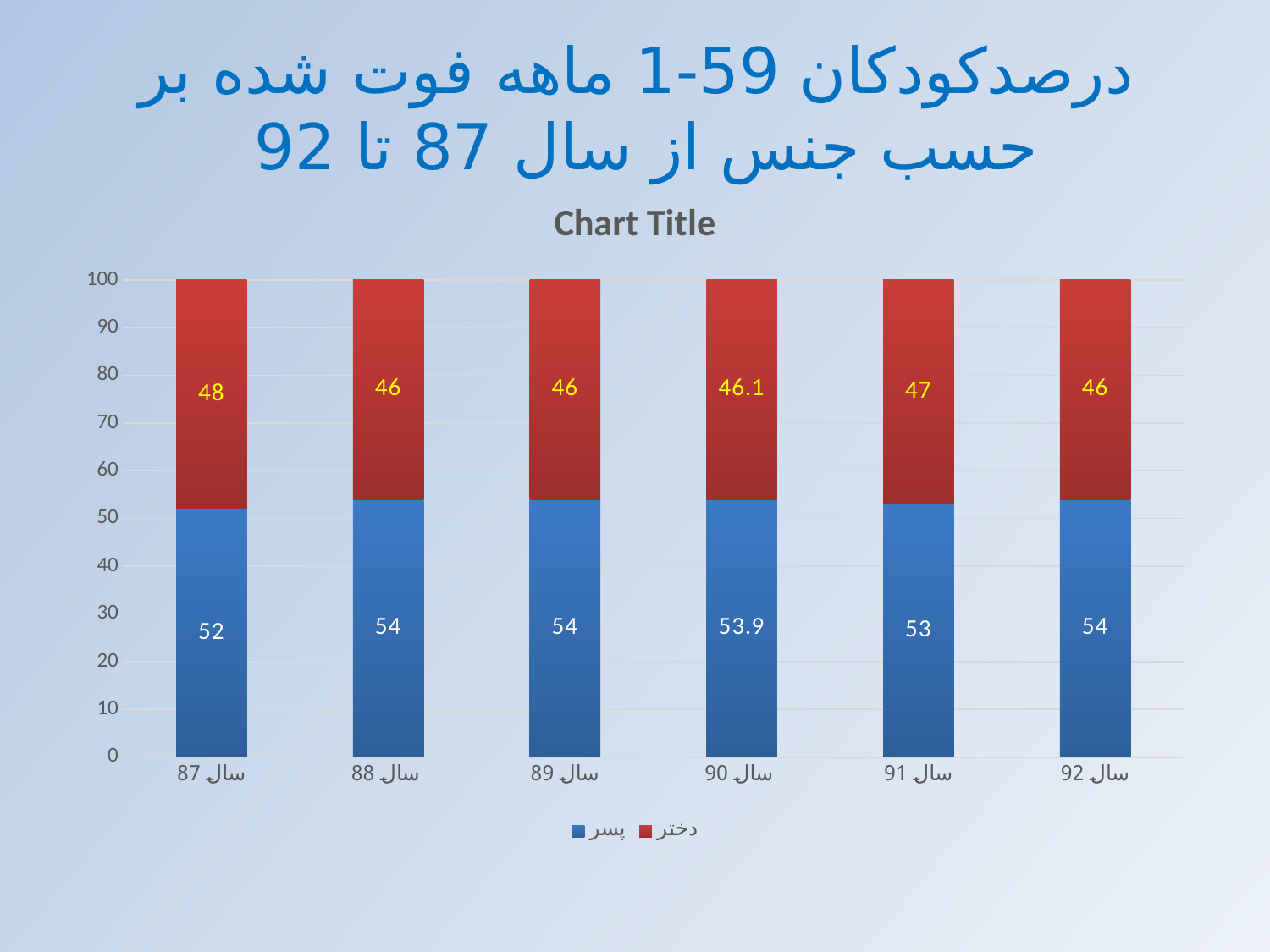
Which is larger in سال 88, the value for پسر or the value for دختر? پسر What is the value for دختر in سال 91? 47 What is the value for دختر in سال 90? 46.1 How many series does the legend list? 2 In which year is the value for پسر lowest? سال 87 What is the value for پسر in سال 87? 52 How many years (categories) are shown on the x axis? 6 In which year is the value for دختر highest? سال 87 What type of chart is shown on the slide? stacked bar chart What is the value for پسر in سال 90? 53.9 What is the difference between the پسر and دختر values in سال 91? 6 What is the total of the stacked bar for سال 92? 100